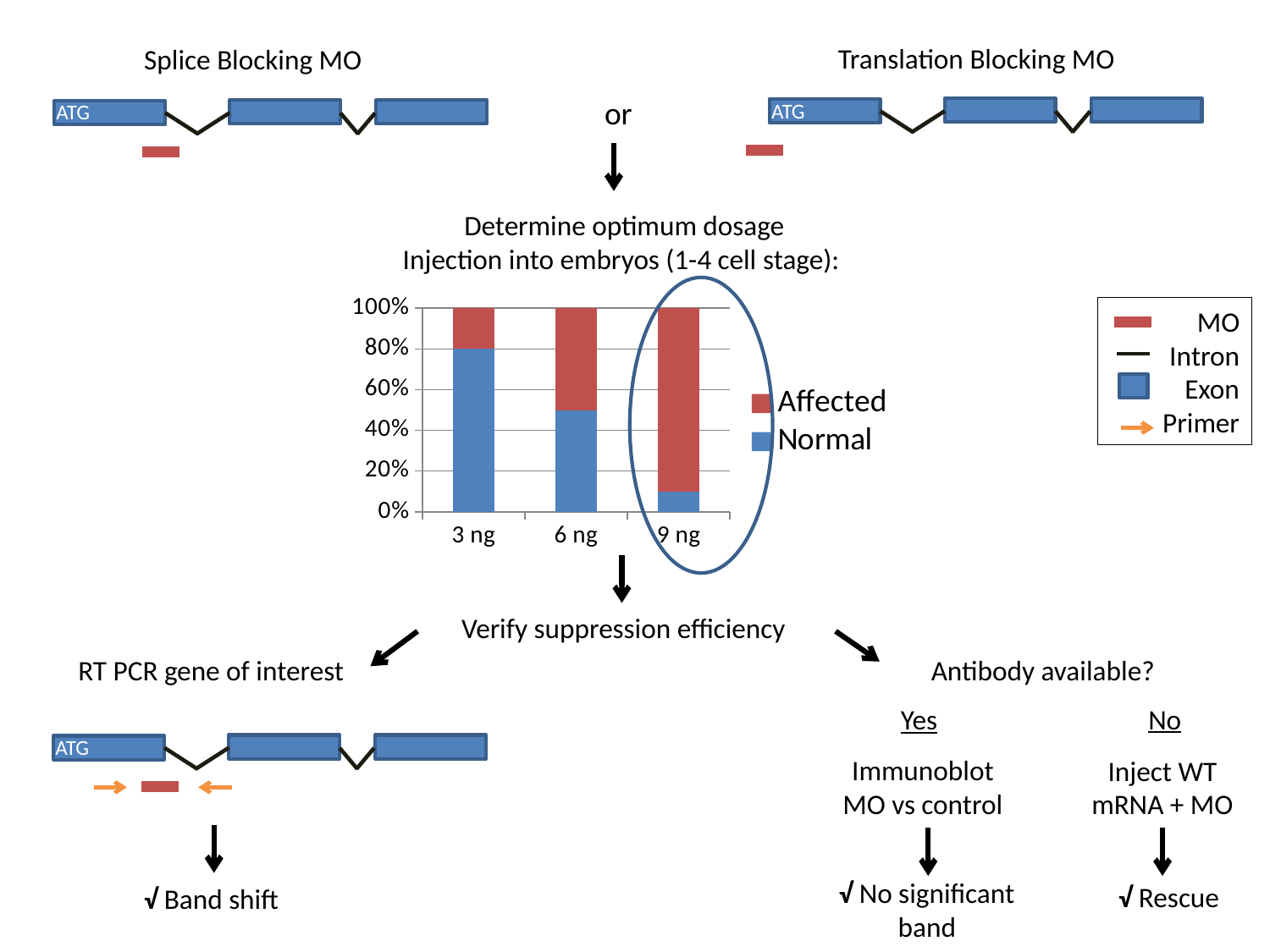
Which dosage has the larger Normal share, 3 ng or 6 ng? 3 ng Which dosage has the highest Normal share? 3 ng What kind of chart is shown under "Determine optimum dosage"? stacked bar chart Which dosage has the lowest Normal share? 9 ng Which dosage bar is circled on the chart? 9 ng Is the Normal share for 9 ng greater or less than 20%? less What is the Normal share for the 3 ng dosage? 80% How many dosage categories are shown on the x axis of the chart? 3 Does the Normal share rise or fall as the dosage increases from 3 ng to 9 ng? fall Is the Normal share for 6 ng greater or less than 40%? greater What is the total height of the stacked bar for 6 ng? 100% How many series does the chart legend list? 2